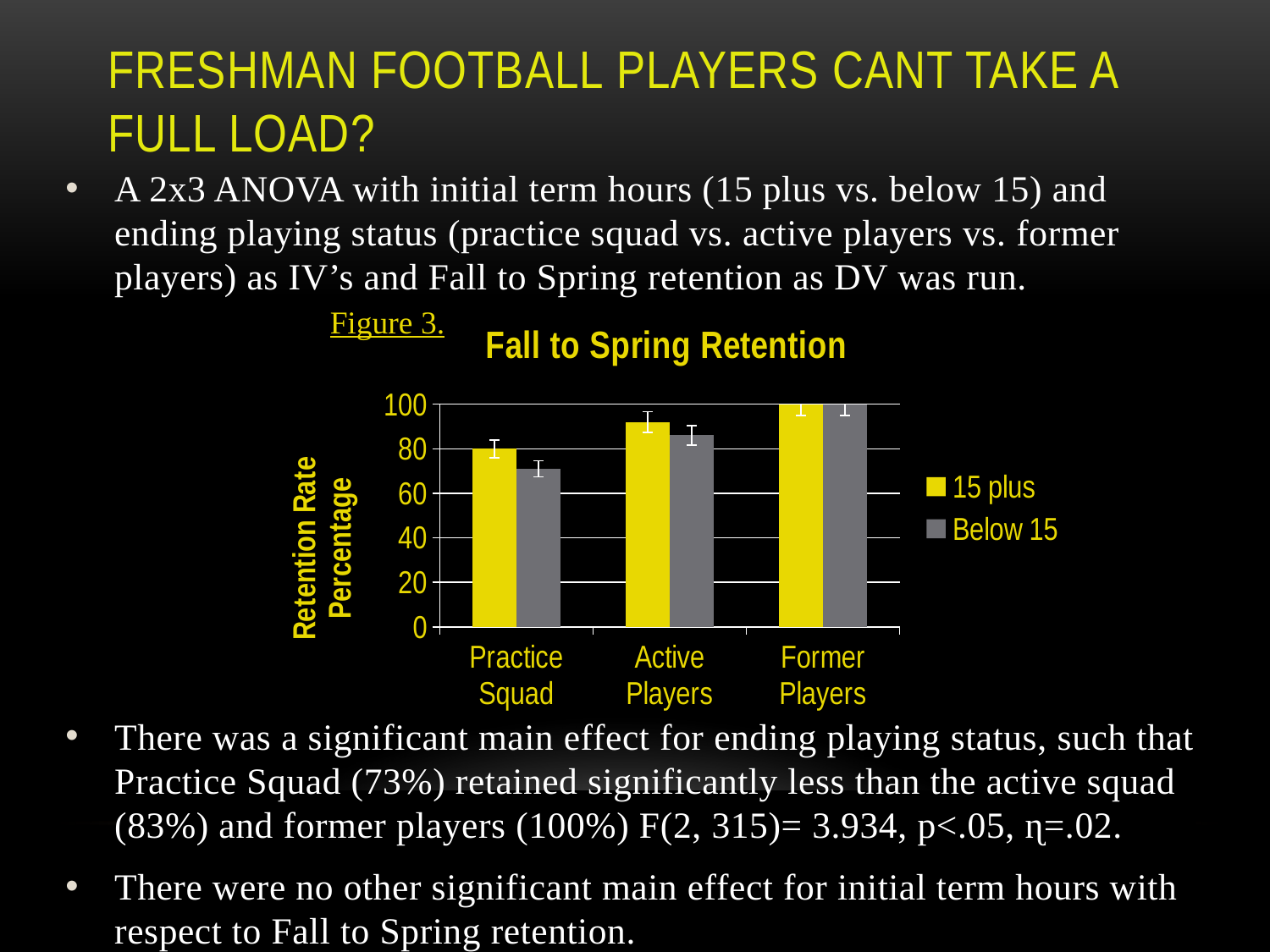
Is the 15 plus value for Active Players greater or less than 80? greater Do the 15 plus values rise or fall from Practice Squad to Former Players along the x axis? rise For Practice Squad, which series has the larger value, 15 plus or Below 15? 15 plus How many series does the chart's legend list? 2 Which category has the highest value for the 15 plus series? Former Players What is the title of the chart? Fall to Spring Retention How many categories are shown on the x axis of the chart? 3 What kind of chart is shown on the slide? bar chart Which category has the lowest value for the Below 15 series? Practice Squad Which series is shown in yellow in the chart? 15 plus Is the Below 15 value for Practice Squad greater or less than 80? less Is the Below 15 value for Active Players greater or less than 80? greater